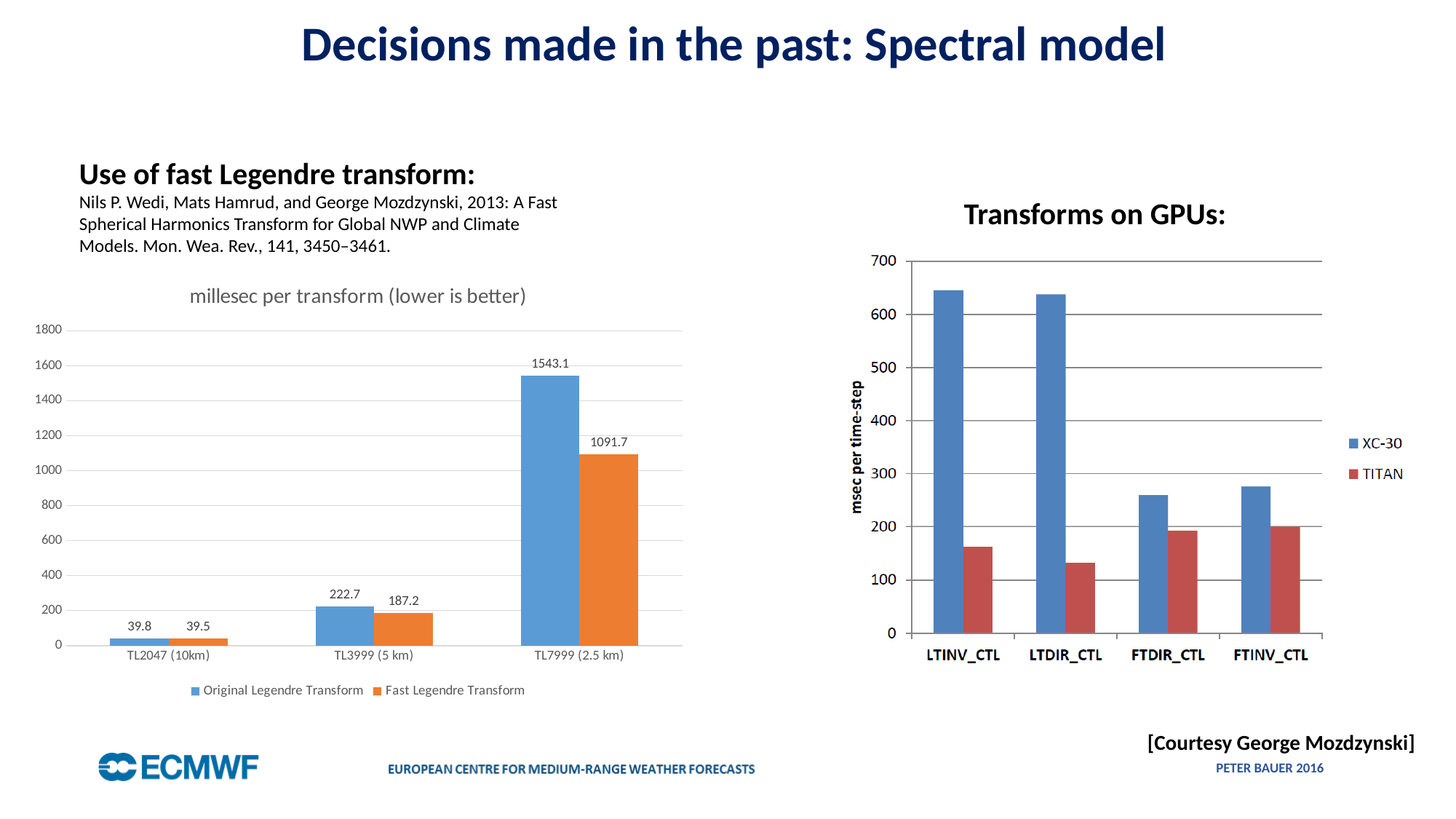
In the 'millesec per transform (lower is better)' chart, how many resolution categories are shown on the x axis? 3 In the 'millesec per transform (lower is better)' chart, how many series does the legend list? 2 In the 'millesec per transform (lower is better)' chart, what is the difference between the Original and Fast Legendre Transform values for TL7999 (2.5 km)? 451.4 In the 'Transforms on GPUs' chart, is the XC-30 value for LTINV_CTL greater or less than 600? greater In the 'millesec per transform (lower is better)' chart, what is the value of the Fast Legendre Transform for TL2047 (10km)? 39.5 In the 'millesec per transform (lower is better)' chart, what is the value of the Fast Legendre Transform for TL3999 (5 km)? 187.2 In the 'Transforms on GPUs' chart, which is larger for FTINV_CTL, XC-30 or TITAN? XC-30 In the 'millesec per transform (lower is better)' chart, which resolution has the highest Original Legendre Transform value? TL7999 (2.5 km) In the 'Transforms on GPUs' chart, which category has the lowest TITAN value? LTDIR_CTL In the 'Transforms on GPUs' chart, is the TITAN value for LTDIR_CTL greater or less than 200? less In the 'millesec per transform (lower is better)' chart, what is the value of the Original Legendre Transform for TL7999 (2.5 km)? 1543.1 What kind of chart is the 'Transforms on GPUs' chart? bar chart